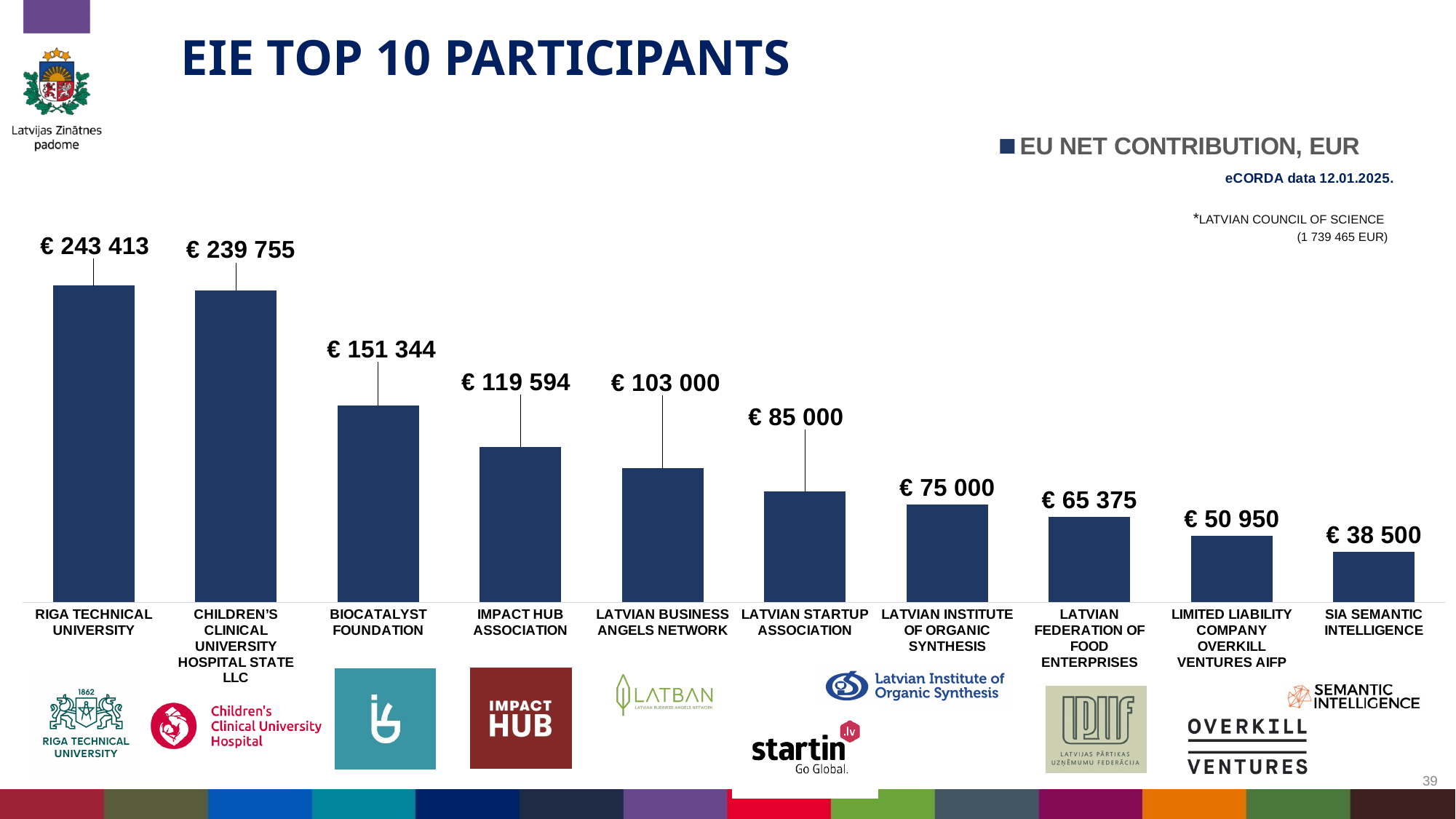
What is the EU net contribution for Latvian Startup Association? € 85 000 What is the difference in EU net contribution between Impact Hub Association and Latvian Business Angels Network? € 16 594 Which participant has the lowest EU net contribution? SIA Semantic Intelligence What is the series name shown in the chart legend? EU NET CONTRIBUTION, EUR Which participant has the highest EU net contribution? Riga Technical University What is the difference in EU net contribution between Riga Technical University and Children's Clinical University Hospital State LLC? € 3 658 How many participants are shown in the chart? 10 What kind of chart is shown on the slide? Bar chart What is the EU net contribution for Biocatalyst Foundation? € 151 344 What is the EU net contribution for Riga Technical University? € 243 413 Which has a larger EU net contribution, Latvian Institute of Organic Synthesis or Latvian Federation of Food Enterprises? Latvian Institute of Organic Synthesis What is the EU net contribution for SIA Semantic Intelligence? € 38 500